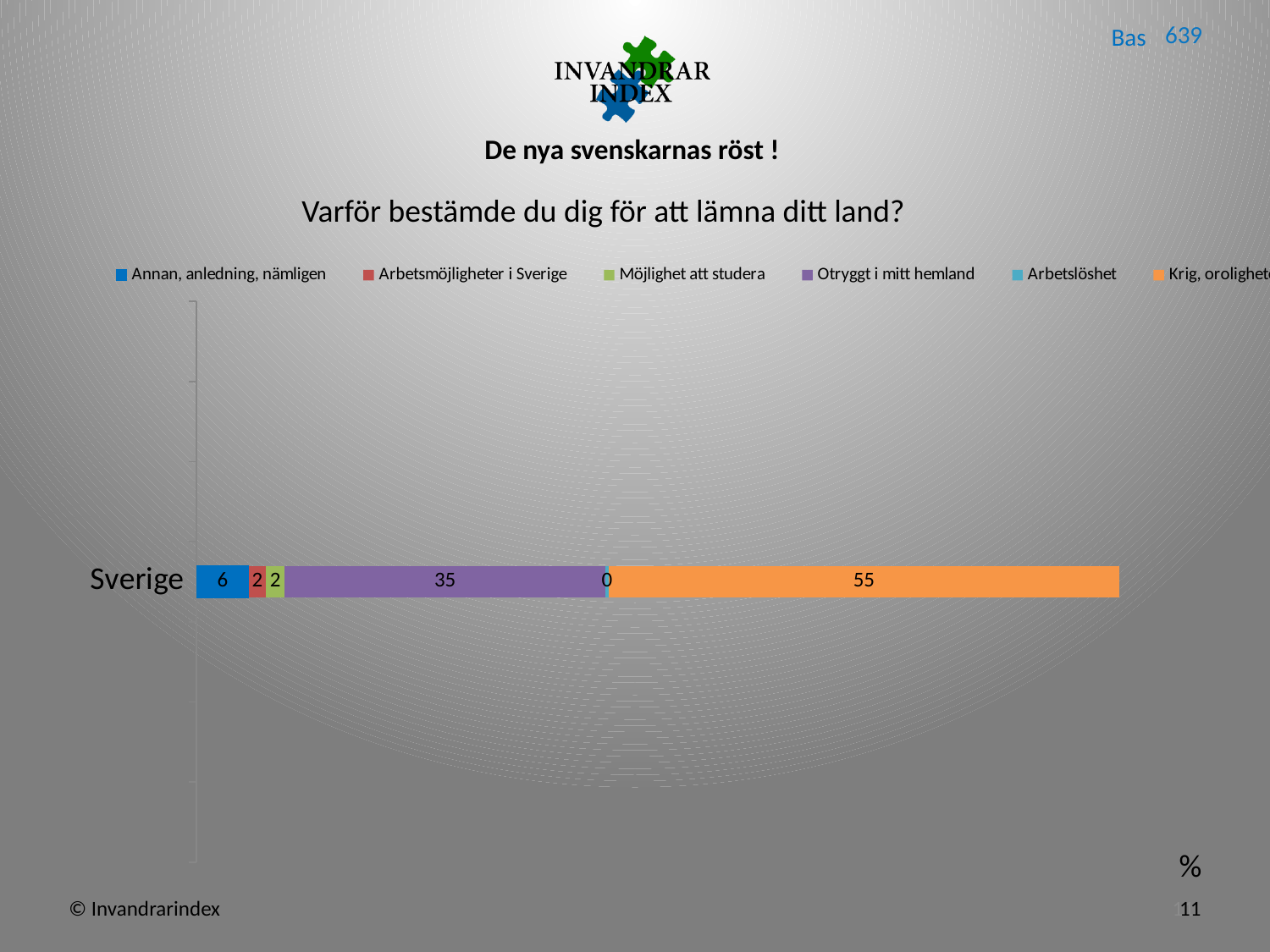
What value is shown for the orange segment (Krig, orolighet...) in the Sverige bar? 55 What value is shown for Arbetsmöjligheter i Sverige in the Sverige bar? 2 How many categories are plotted on the chart? 1 Which is larger: the value for Otryggt i mitt hemland or the value for Möjlighet att studera? Otryggt i mitt hemland What kind of chart is shown on the slide? Stacked bar chart What is the difference between the values for Otryggt i mitt hemland and Annan, anledning, nämligen? 29 What value is shown for Annan, anledning, nämligen in the Sverige bar? 6 What value is shown for Otryggt i mitt hemland in the Sverige bar? 35 How many series does the legend list? 6 What value is shown for Arbetslöshet in the Sverige bar? 0 Which series has the smallest value in the Sverige bar? Arbetslöshet What is the total of all segments in the Sverige bar? 100